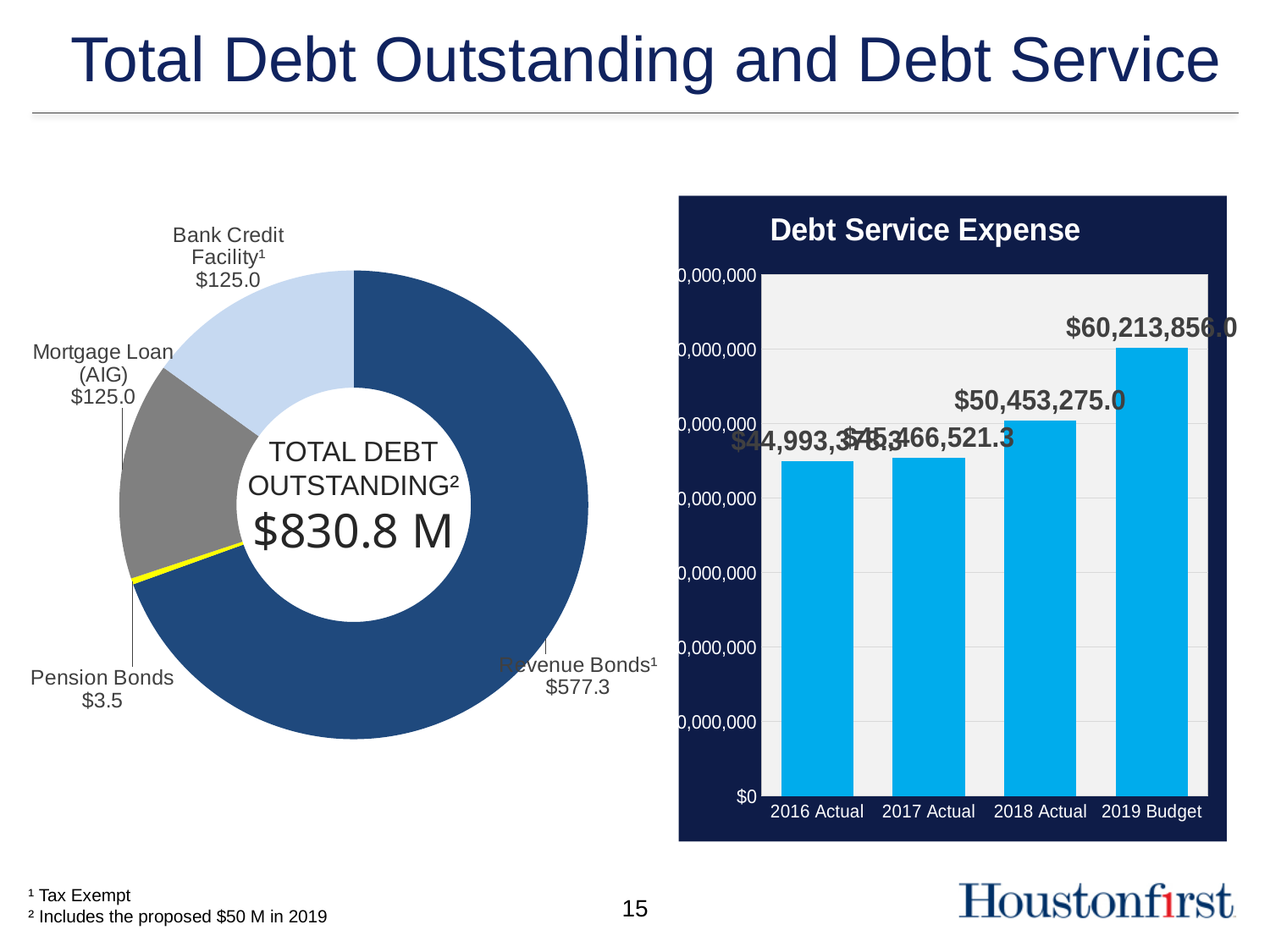
In the Debt Service Expense chart, which category has the highest value? 2019 Budget In the Total Debt Outstanding donut chart, what is the difference between Revenue Bonds and Bank Credit Facility? $452.3 In the Total Debt Outstanding donut chart, what total is shown in the centre? $830.8 M In the Total Debt Outstanding donut chart, which category has the smallest value? Pension Bonds In the Total Debt Outstanding donut chart, how many categories are shown? 4 What kind of chart is the Debt Service Expense chart? bar chart In the Debt Service Expense chart, what is the value for 2019 Budget? $60,213,856.0 In the Debt Service Expense chart, do the values rise or fall from 2016 Actual to 2019 Budget? rise In the Total Debt Outstanding donut chart, what is the value for Revenue Bonds? $577.3 In the Debt Service Expense chart, what is the value for 2018 Actual? $50,453,275.0 In the Total Debt Outstanding donut chart, what is the value for Pension Bonds? $3.5 In the Total Debt Outstanding donut chart, which category has the largest value? Revenue Bonds